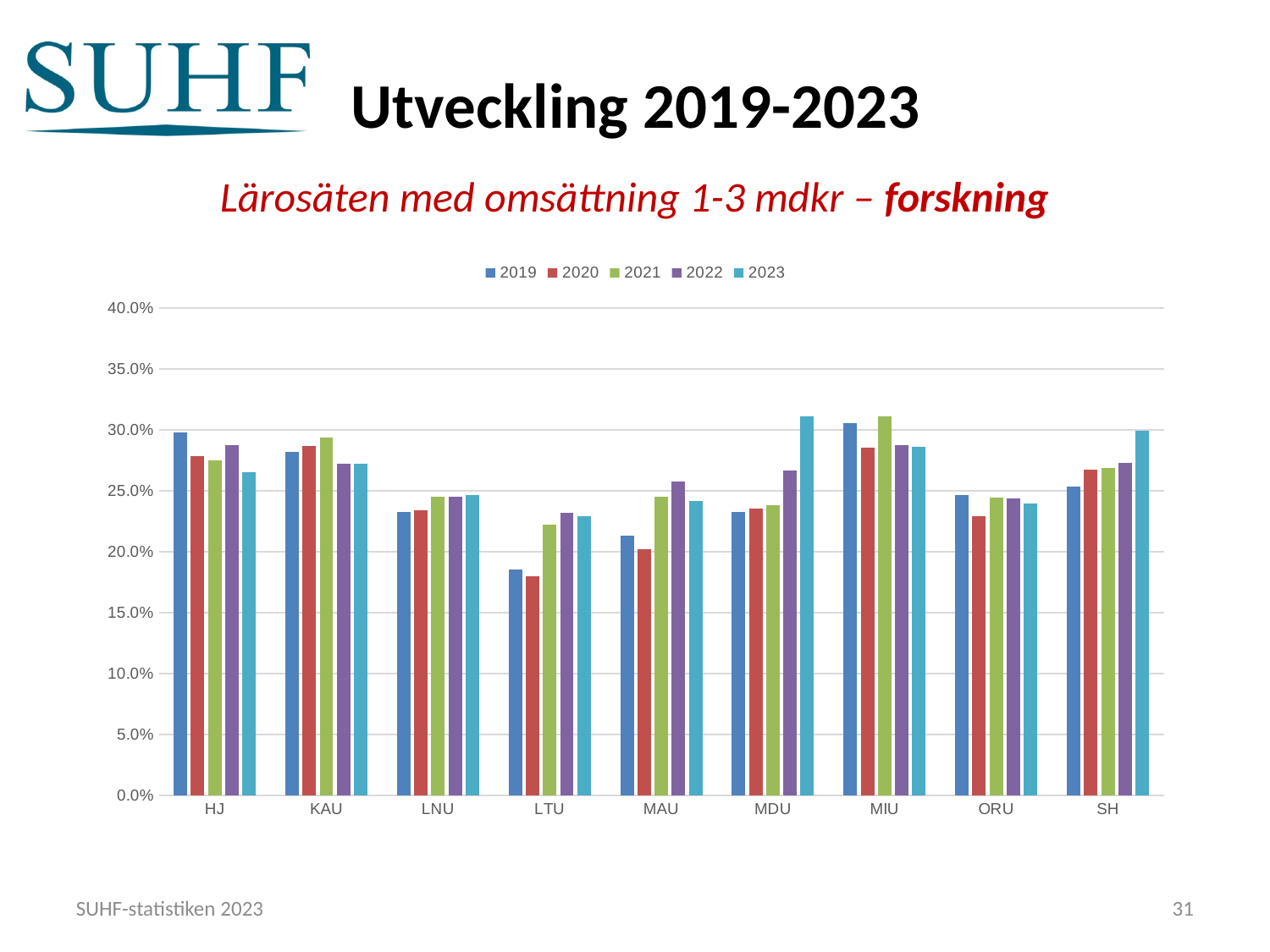
What kind of chart is shown on the slide? bar chart Do the values for MDU rise or fall from 2019 to 2023? rise Which is larger for LTU: the 2019 value or the 2021 value? 2021 Is the value for LTU in 2020 greater or less than 20.0%? less Is the value for MIU in 2021 greater or less than 30.0%? greater Which category has the highest value for 2023? MDU What is the subtitle of the chart shown on the slide? Lärosäten med omsättning 1-3 mdkr – forskning Which category has the lowest value for 2020? LTU How many categories (lärosäten) are shown on the x axis? 9 Is the value for LNU in 2019 greater or less than 25.0%? less How many series does the legend list? 5